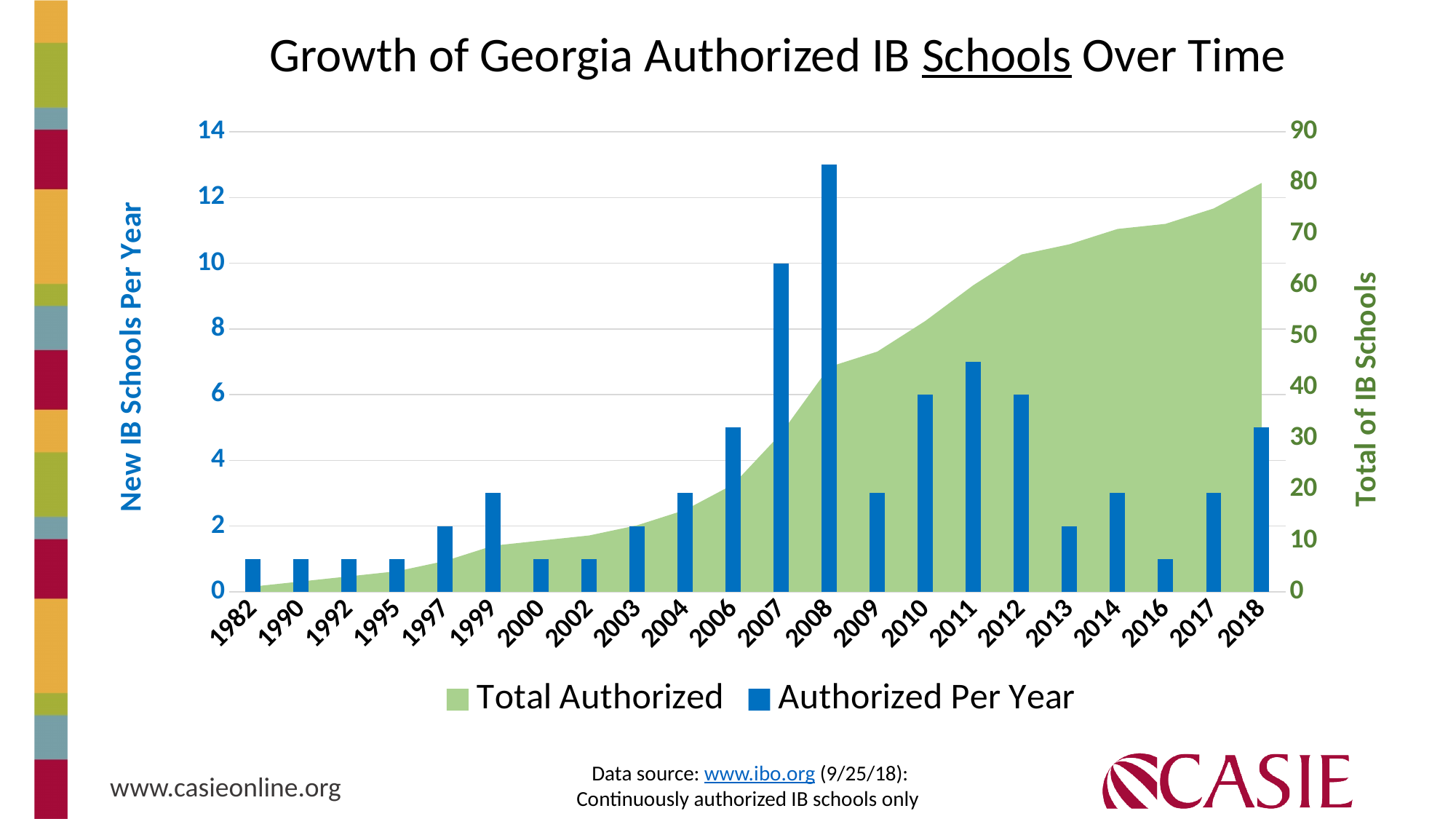
What kind of chart is this? Combination bar and area chart What is the title of the chart? Growth of Georgia Authorized IB Schools Over Time How many years are shown on the x axis? 22 Which year had more schools authorized per year, 2007 or 2010? 2007 What is the difference between the number of schools authorized per year in 2007 and in 2010? 4 Is the value for Authorized Per Year in 2008 greater or less than 12? greater How many IB schools were authorized per year in 2010? 6 How many IB schools were authorized per year in 2013? 2 Which year has the highest number of IB schools authorized per year? 2008 Does the Total Authorized series rise or fall from 1982 to 2018? Rises How many IB schools were authorized per year in 2007? 10 How many series does the legend list? 2